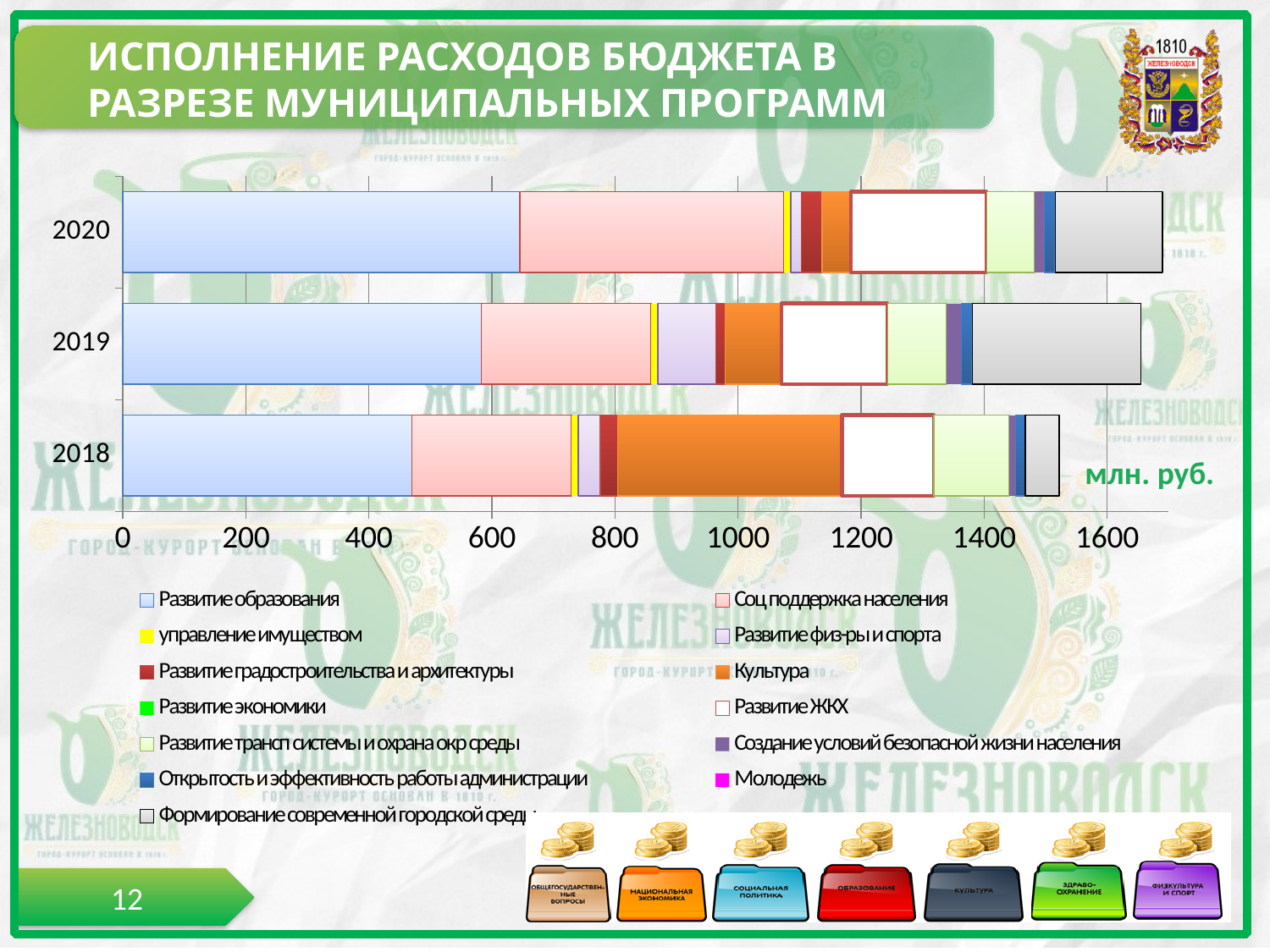
Which year has the shortest total bar? 2018 What unit of measurement is indicated on the chart? млн. руб. How many series does the chart legend list? 13 In which year is the 'Культура' segment the largest? 2018 Is the value of the 'Развитие образования' segment for 2020 greater or less than 600? greater Is the total bar for 2020 greater or less than 1600? greater Which year has the longest total bar? 2020 Do the total bar lengths rise or fall from 2018 to 2020? rise How many years (categories) are plotted on the chart? 3 What kind of chart is shown on the slide? stacked bar chart Is the value of the 'Развитие образования' segment for 2018 greater or less than 600? less